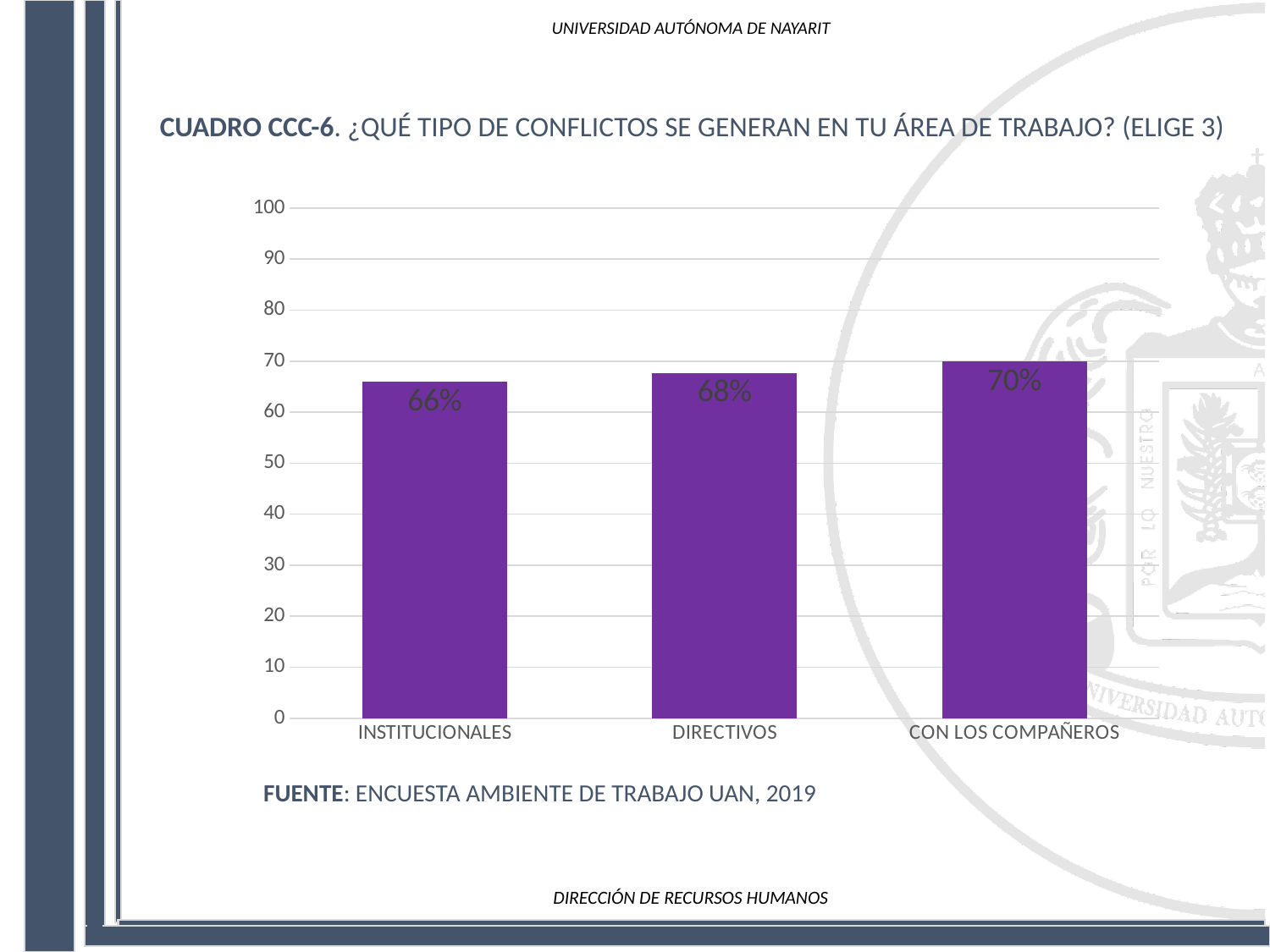
What kind of chart is shown on the slide? bar chart What is the difference between the values for CON LOS COMPAÑEROS and INSTITUCIONALES? 4% Which category has the highest value? CON LOS COMPAÑEROS What is the difference between the values for DIRECTIVOS and INSTITUCIONALES? 2% What is the value for CON LOS COMPAÑEROS? 70% Which is larger, the value for DIRECTIVOS or the value for INSTITUCIONALES? DIRECTIVOS Do the values rise or fall from left to right along the x axis? rise Which category has the lowest value? INSTITUCIONALES What is the value for INSTITUCIONALES? 66% How many categories are shown on the x axis? 3 What is the value for DIRECTIVOS? 68% Is the value for INSTITUCIONALES greater or less than 70? less